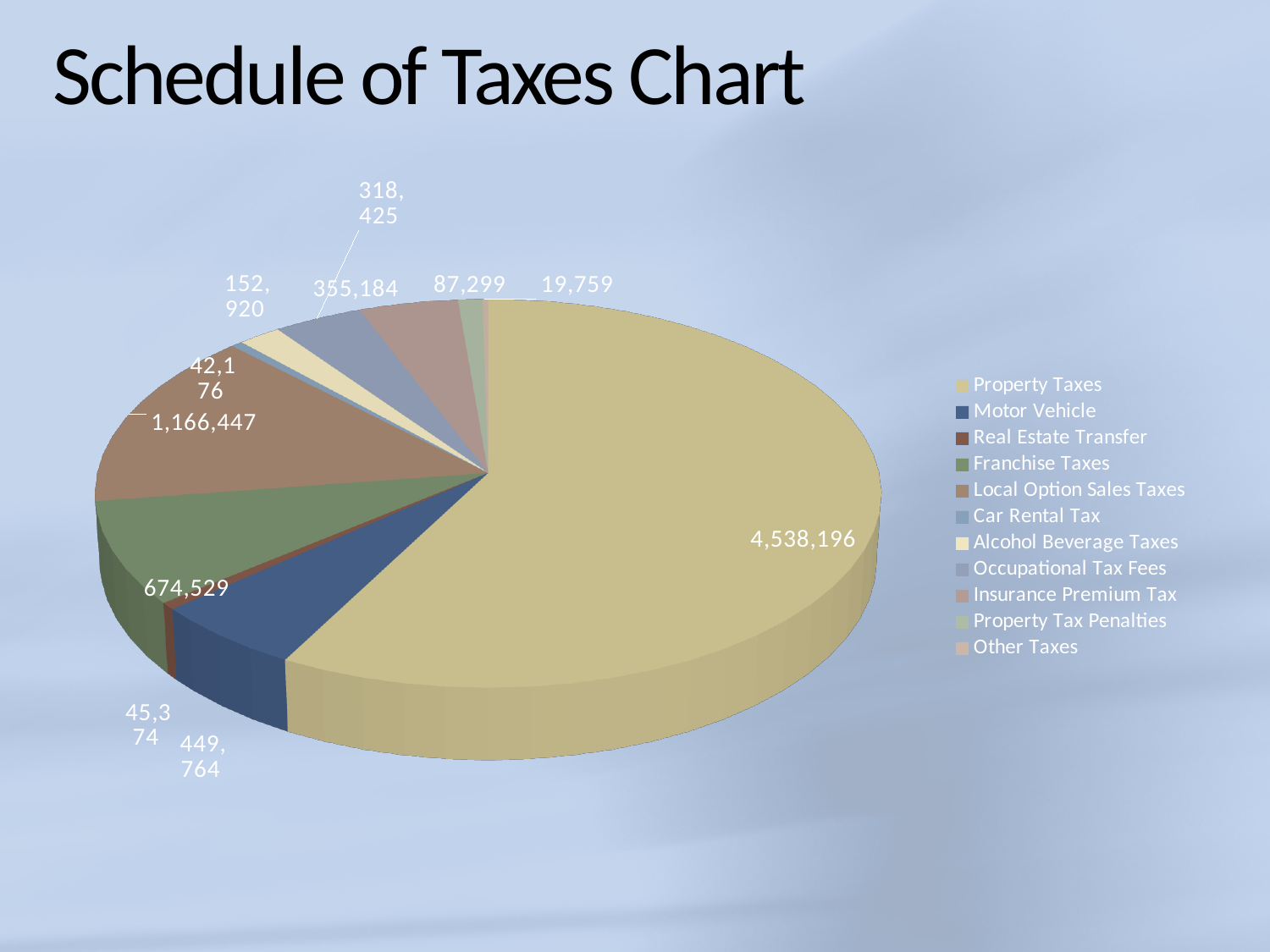
Which is larger, Franchise Taxes or Motor Vehicle? Franchise Taxes What is the value for Property Taxes? 4,538,196 Which is larger, Local Option Sales Taxes or Franchise Taxes? Local Option Sales Taxes What is the value for Motor Vehicle? 449,764 What is the difference between Franchise Taxes and Motor Vehicle? 224,765 What is the value for Franchise Taxes? 674,529 What is the value for Local Option Sales Taxes? 1,166,447 Which category has the largest slice of the pie? Property Taxes What is the title of the chart? Schedule of Taxes Chart How many categories does the legend list? 11 What type of chart is shown on the slide? Pie chart What is the difference between Property Taxes and Local Option Sales Taxes? 3,371,749